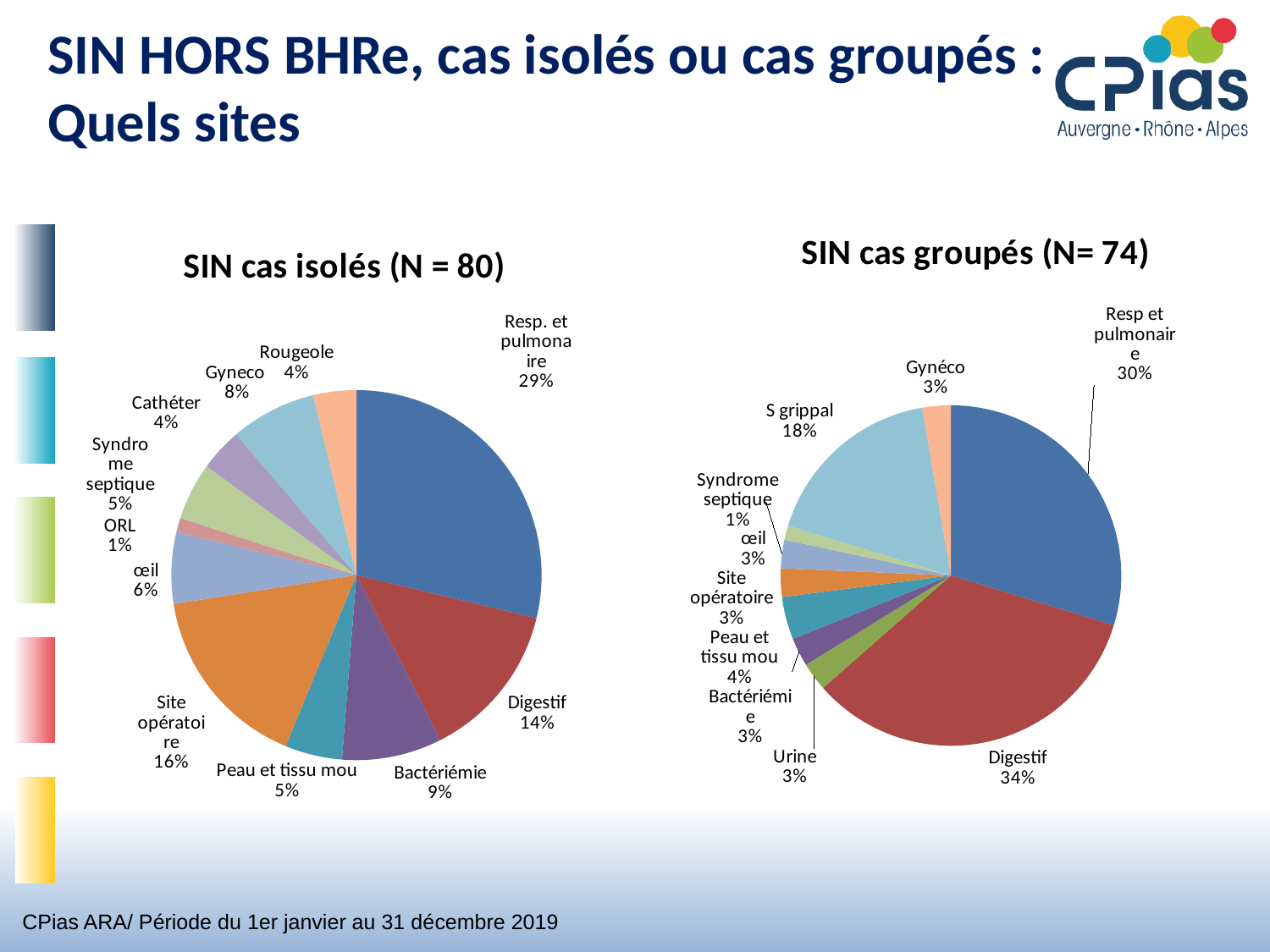
In the 'SIN cas groupés (N= 74)' chart, which is larger, 'Digestif' or 'Resp et pulmonaire'? Digestif In the 'SIN cas isolés (N = 80)' chart, what is the value for 'Site opératoire'? 16% In the 'SIN cas groupés (N= 74)' chart, which category has the largest share? Digestif In the 'SIN cas isolés (N = 80)' chart, what share does 'Resp. et pulmonaire' represent? 29% In the 'SIN cas isolés (N = 80)' chart, which category has the smallest share? ORL What type of chart is 'SIN cas groupés (N= 74)'? Pie chart In the 'SIN cas groupés (N= 74)' chart, what is the difference between 'S grippal' and 'Syndrome septique'? 17% In the 'SIN cas groupés (N= 74)' chart, how many slices does the pie have? 10 In the 'SIN cas isolés (N = 80)' chart, which category has the largest share? Resp. et pulmonaire In the 'SIN cas isolés (N = 80)' chart, how many slices does the pie have? 11 In the 'SIN cas groupés (N= 74)' chart, what is the value for 'S grippal'? 18% In the 'SIN cas isolés (N = 80)' chart, what is the difference between 'Digestif' and 'Bactériémie'? 5%